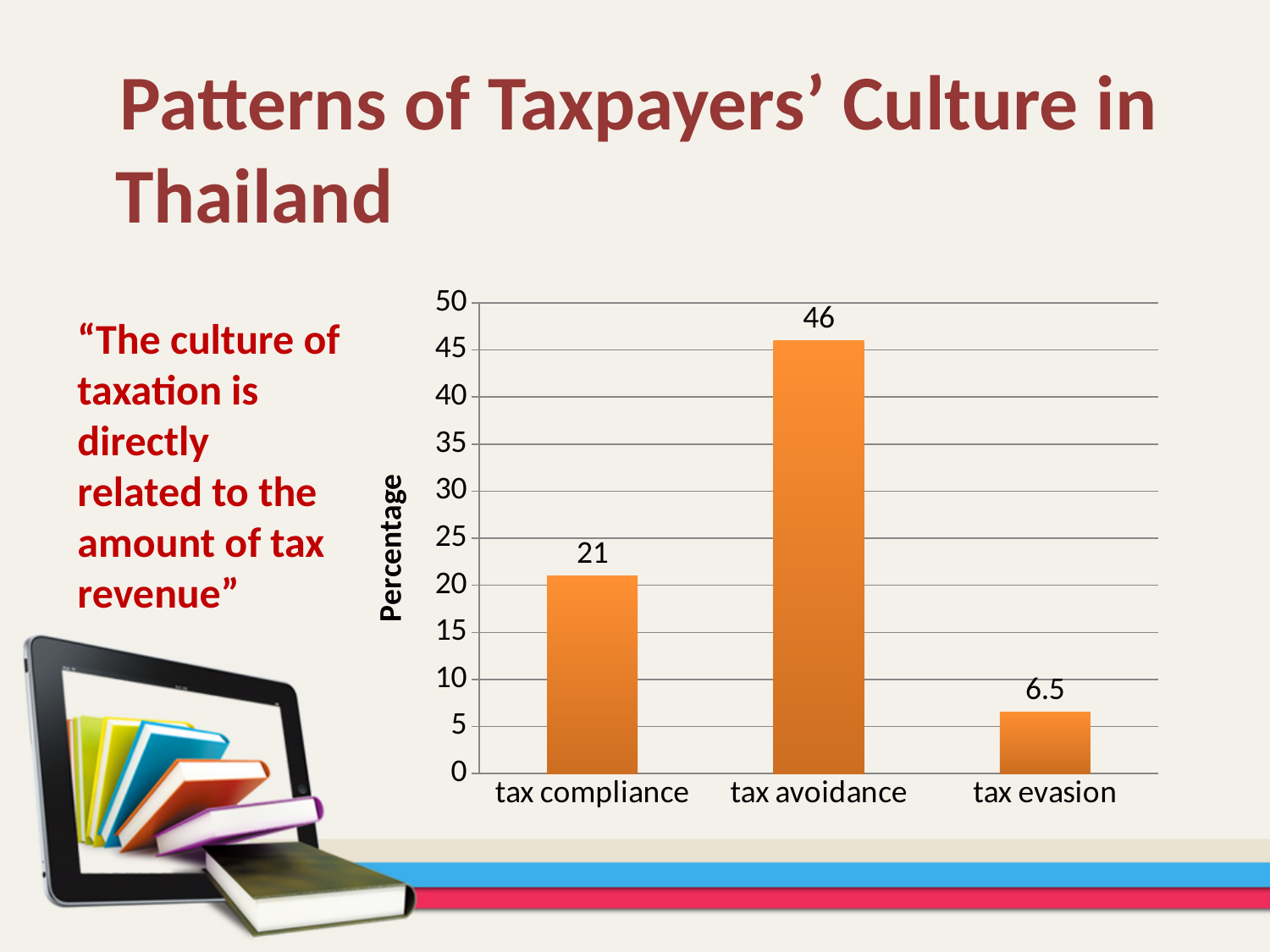
What is the percentage value for tax avoidance? 46 What is the difference between the values for tax avoidance and tax compliance? 25 What is the percentage value for tax compliance? 21 What kind of chart is shown on the slide? bar chart Which is larger, the value for tax compliance or the value for tax evasion? tax compliance What is the difference between the values for tax compliance and tax evasion? 14.5 Which category has the lowest percentage? tax evasion Is the value for tax avoidance greater or less than 40? greater What is the label of the vertical axis of the chart? Percentage Which category has the highest percentage? tax avoidance How many categories are shown on the x axis of the chart? 3 What is the percentage value for tax evasion? 6.5